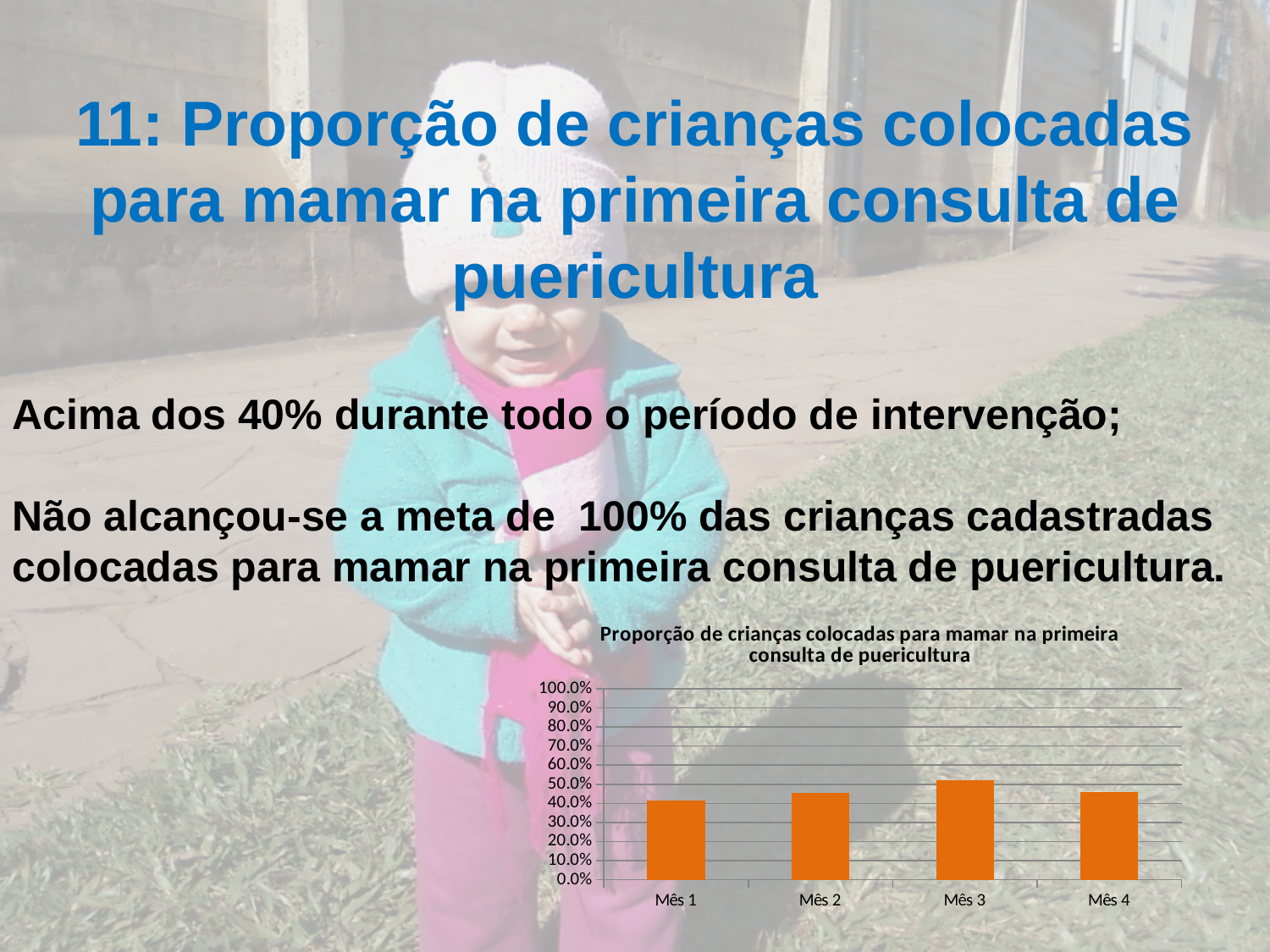
Is the value for Mês 1 greater or less than 50.0%? less What is the highest value shown on the chart's y axis? 100.0% Which is larger, the value for Mês 1 or the value for Mês 3? Mês 3 Which month has the lowest proportion in the chart? Mês 1 What is the title of the chart? Proporção de crianças colocadas para mamar na primeira consulta de puericultura What kind of chart is shown on the slide? bar chart How many months (categories) are shown on the x axis of the chart? 4 Is the value for Mês 4 greater or less than 30.0%? greater Is the value for Mês 3 greater or less than 50.0%? greater Do the values rise or fall from Mês 1 to Mês 3? rise Which month has the highest proportion in the chart? Mês 3